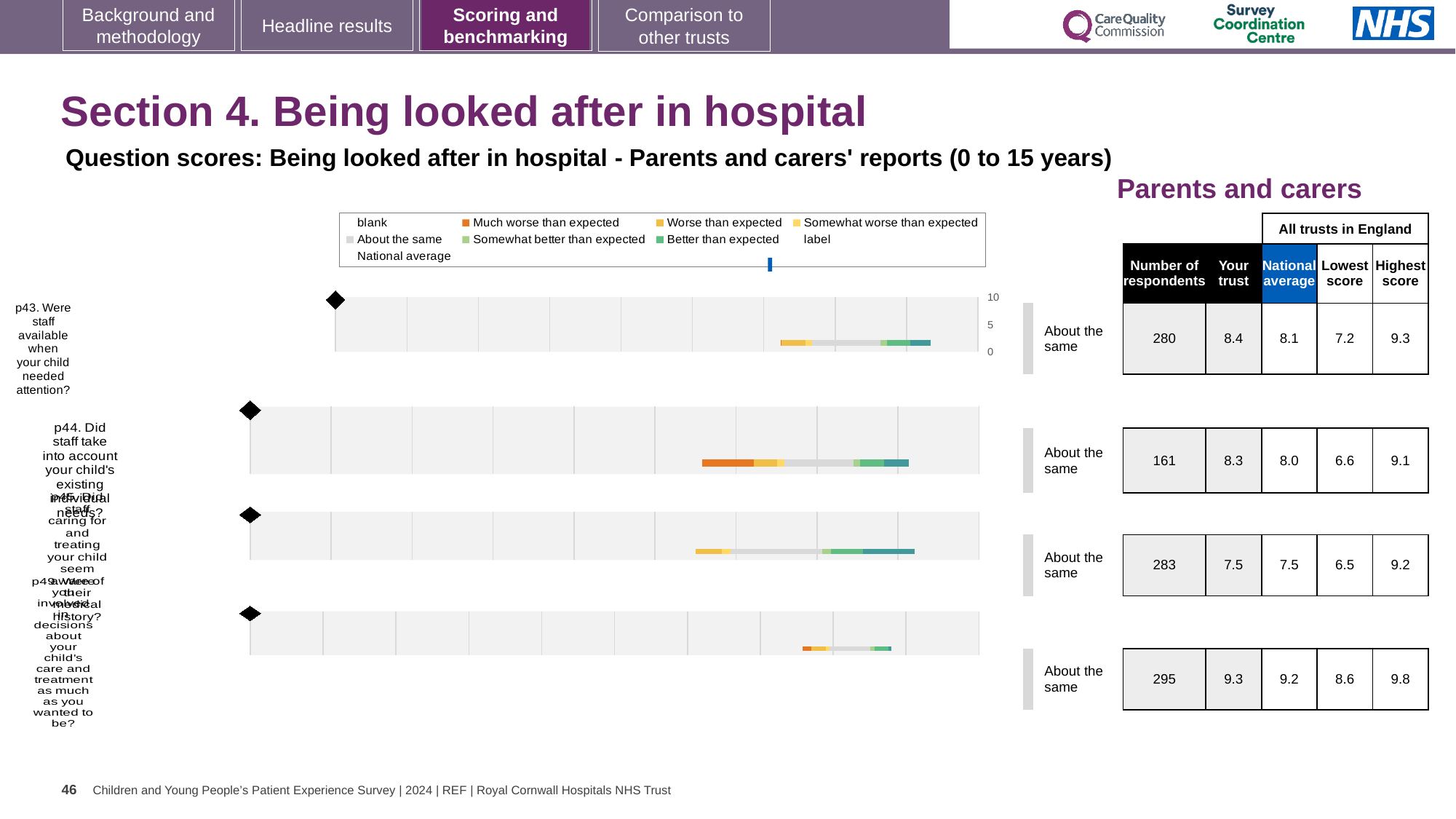
In the table next to the charts, what is the 'Your trust' score for p43 (Were staff available when your child needed attention?)? 8.4 Which legend entry is shown in orange? Much worse than expected Which of the four charts has the lowest 'Your trust' score in the table? the third chart, p45 Which of the four charts has the highest 'Your trust' score in the table? the fourth (bottom) chart, p49 Is the 'Your trust' score for the first chart (p43) larger or smaller than its National average? larger How many question charts are shown on the slide? 4 Which question number does the first (top) chart relate to? p43 In the table next to the charts, what is the National average for the second chart (p44)? 8.0 What is the highest tick value shown on the score axis of the first chart? 10 What is the difference between the Highest score and Lowest score for the first chart (p43) in the table? 2.1 In the table next to the charts, what is the number of respondents for the fourth (bottom) chart? 295 What kind of chart is used to show the question scores on this slide? bar chart